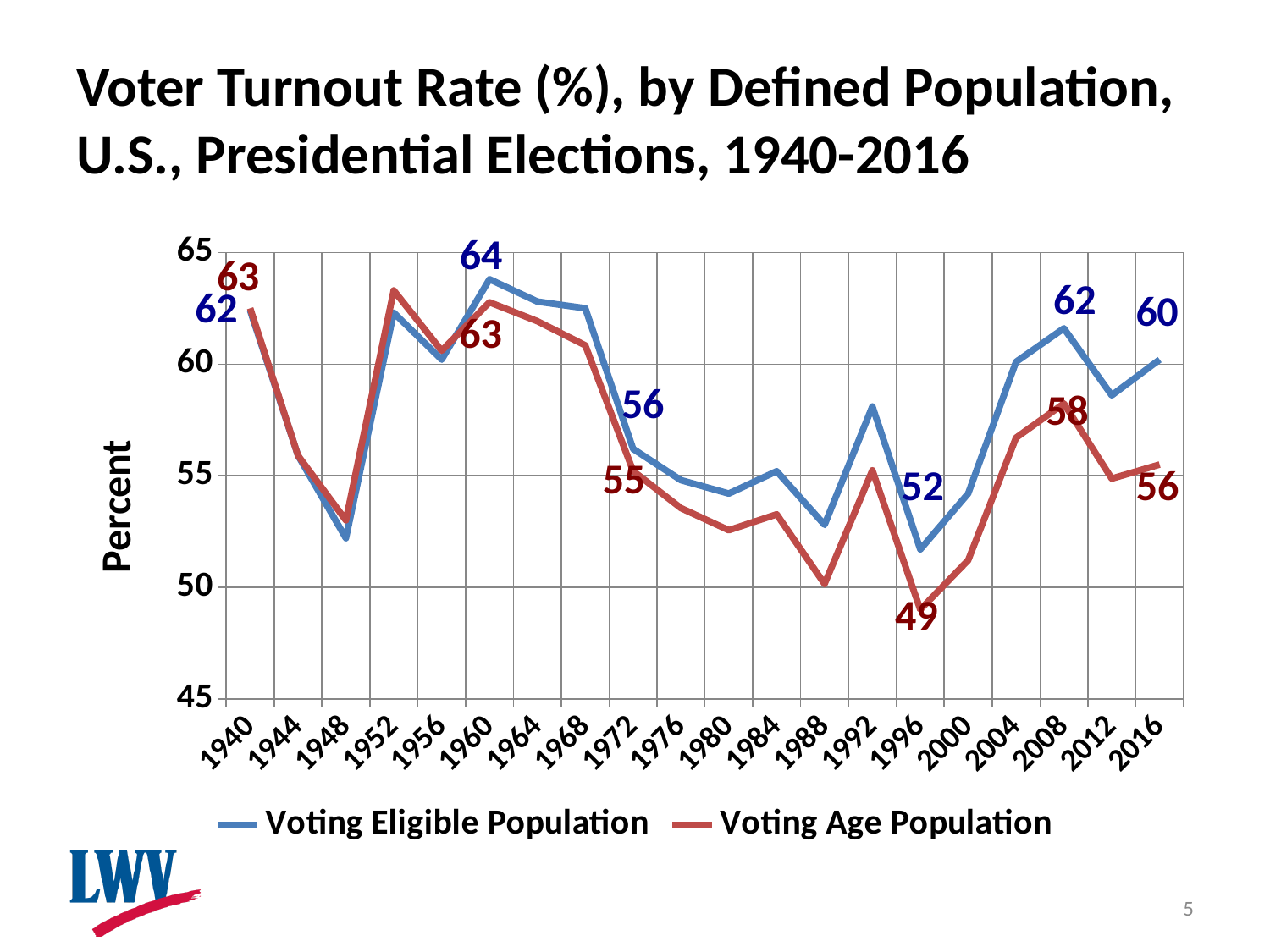
How many series does the legend list? 2 What is the Voting Age Population turnout rate in 2008? 58 In 1996, how many percentage points higher is the Voting Eligible Population rate than the Voting Age Population rate? 3 What kind of chart is shown on the slide? line chart What is the Voting Age Population turnout rate in 1996? 49 In 1940, which series has the higher turnout rate? Voting Age Population How many election years are plotted on the x axis? 20 Is the Voting Eligible Population value for 1948 greater or less than 55? less What is the Voting Eligible Population turnout rate in 2016? 60 What is the Voting Eligible Population turnout rate in 1960? 64 In which year does the Voting Eligible Population line reach its highest value? 1960 In which year does the Voting Age Population line reach its lowest value? 1996